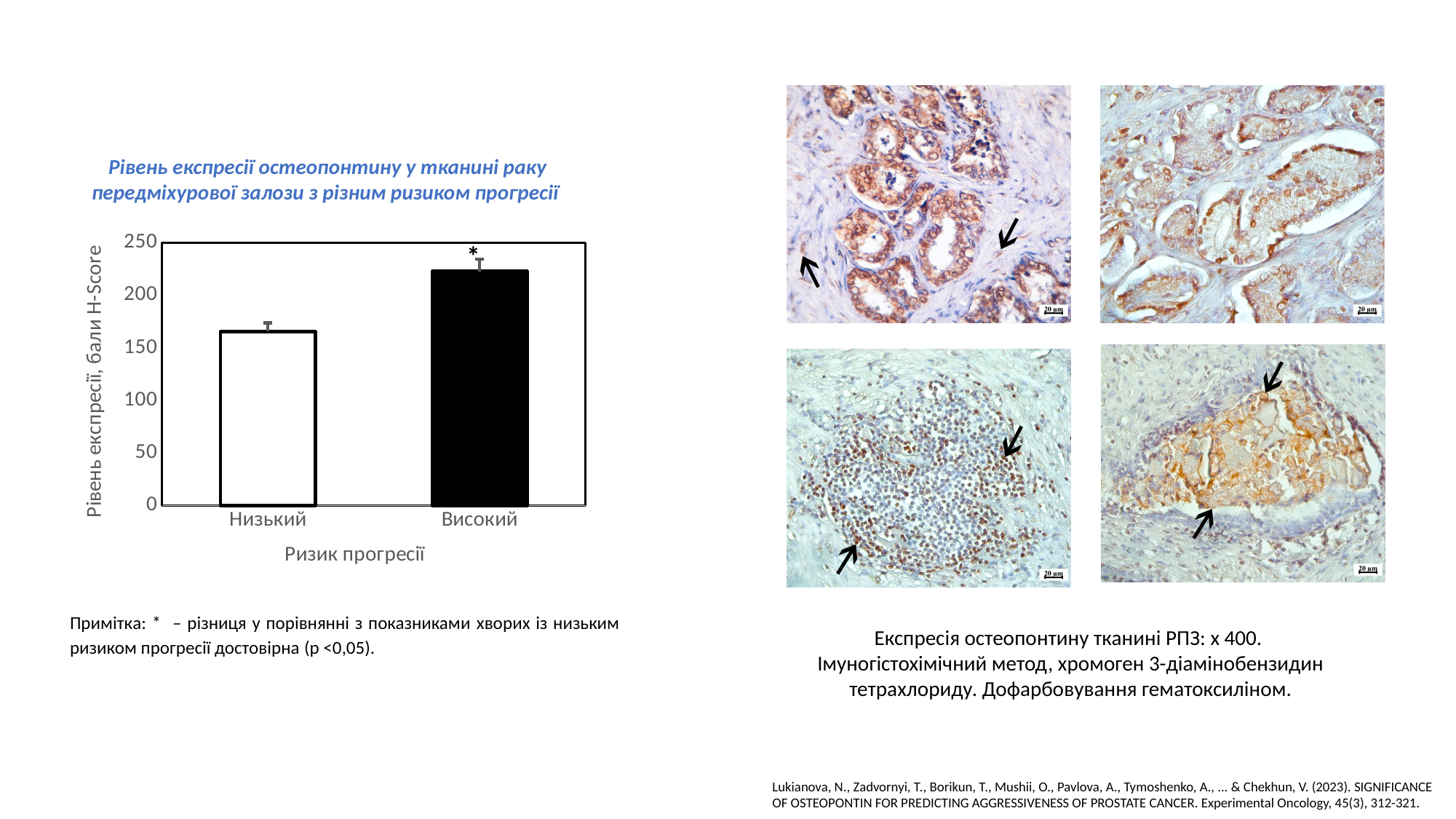
Do the bar values rise or fall from Низький to Високий along the x axis? rise Is the value for Високий greater or less than 200? greater How many categories are shown on the x axis of the bar chart? 2 Which bar is taller, Низький or Високий? Високий Is the value for Низький greater or less than 200? less Which category has the highest bar in the chart? Високий Is the value for Високий greater or less than 250? less Which category has the lowest bar in the chart? Низький What kind of chart is shown on the slide? bar chart What is the label of the y axis of the chart? Рівень експресії, бали H-Score What is the label of the x axis of the chart? Ризик прогресії